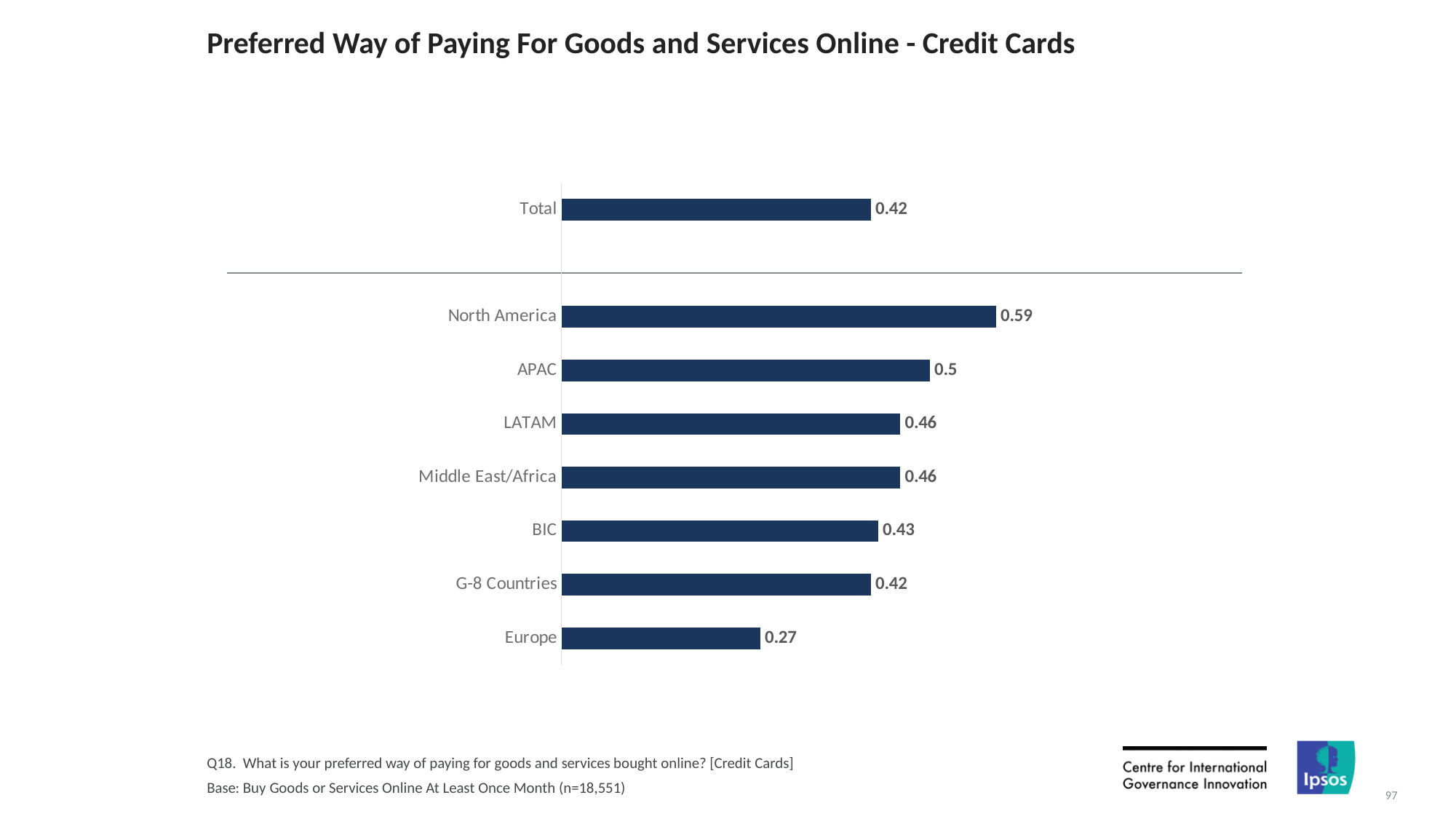
What kind of chart is shown on the slide? Bar chart What is the value for Europe? 0.27 What is the value for North America? 0.59 Which region has the lowest value? Europe Which is larger, the value for APAC or the value for LATAM? APAC What is the difference between the values for APAC and G-8 Countries? 0.08 What is the value for BIC? 0.43 What is the difference between the values for North America and Europe? 0.32 How many bars are shown on the chart, including Total? 8 What is the title of the chart? Preferred Way of Paying For Goods and Services Online - Credit Cards Which region has the highest value? North America What is the value for the Total bar? 0.42